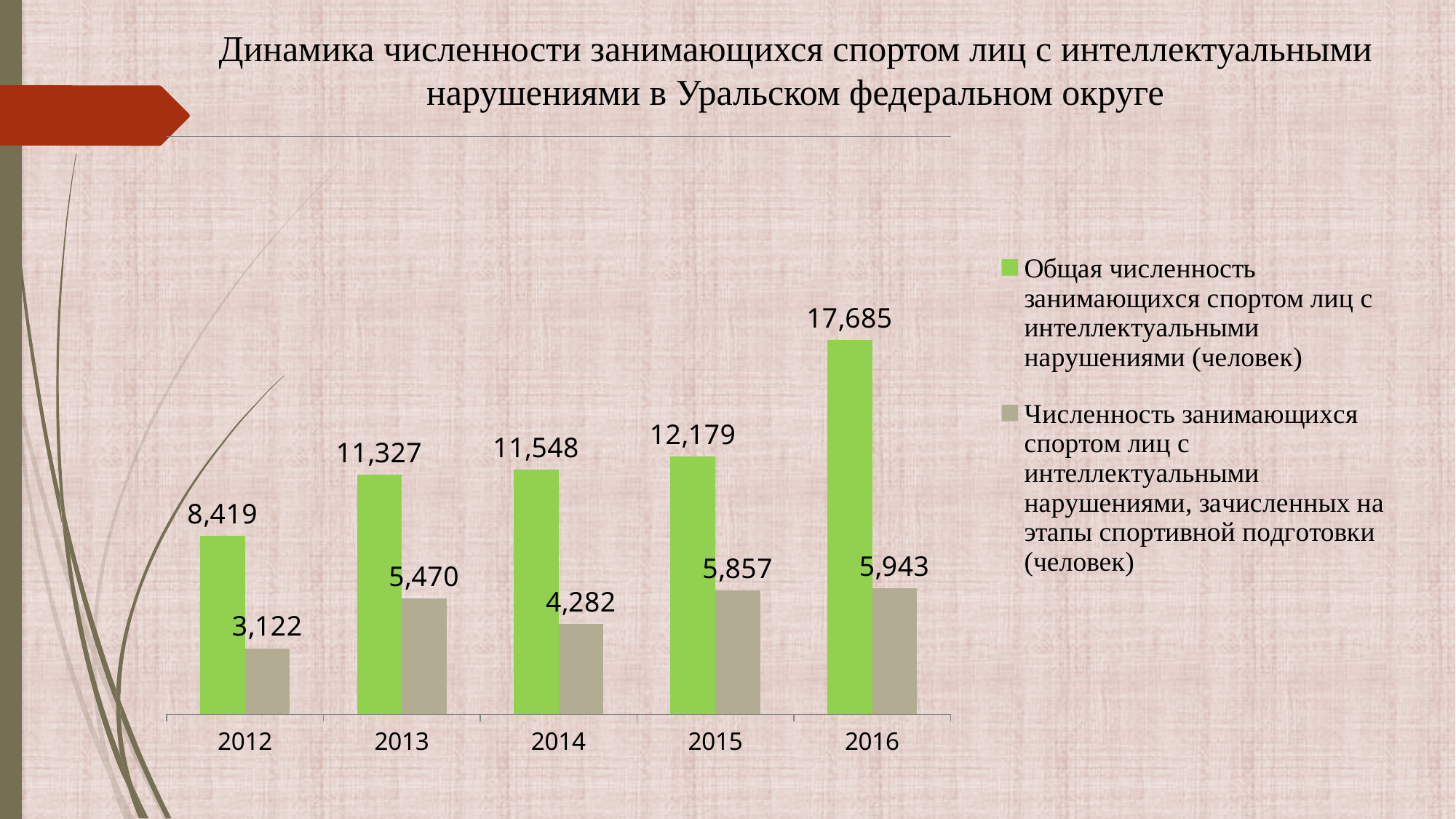
How many series does the legend list? 2 What is the number of people enrolled in sports training stages (grey series) in 2014? 4,282 What is the value of the green series (total number engaged in sport) in 2012? 8,419 In which year is the total number of people engaged in sport (green series) the highest? 2016 Which is larger: the grey series value in 2013 or in 2014? 2013 What is the total number of people with intellectual disabilities engaged in sport (green series) in 2016? 17,685 Does the total number of people engaged in sport (green series) rise or fall from 2012 to 2016? Rise How many years are shown on the x axis of the chart? 5 What kind of chart is shown on the slide? Bar chart What is the difference between the total number engaged in sport and the number enrolled in training stages in 2012? 5,297 In which year is the number enrolled in sports training stages (grey series) the lowest? 2012 What is the difference between the total number engaged in sport in 2016 and in 2015? 5,506